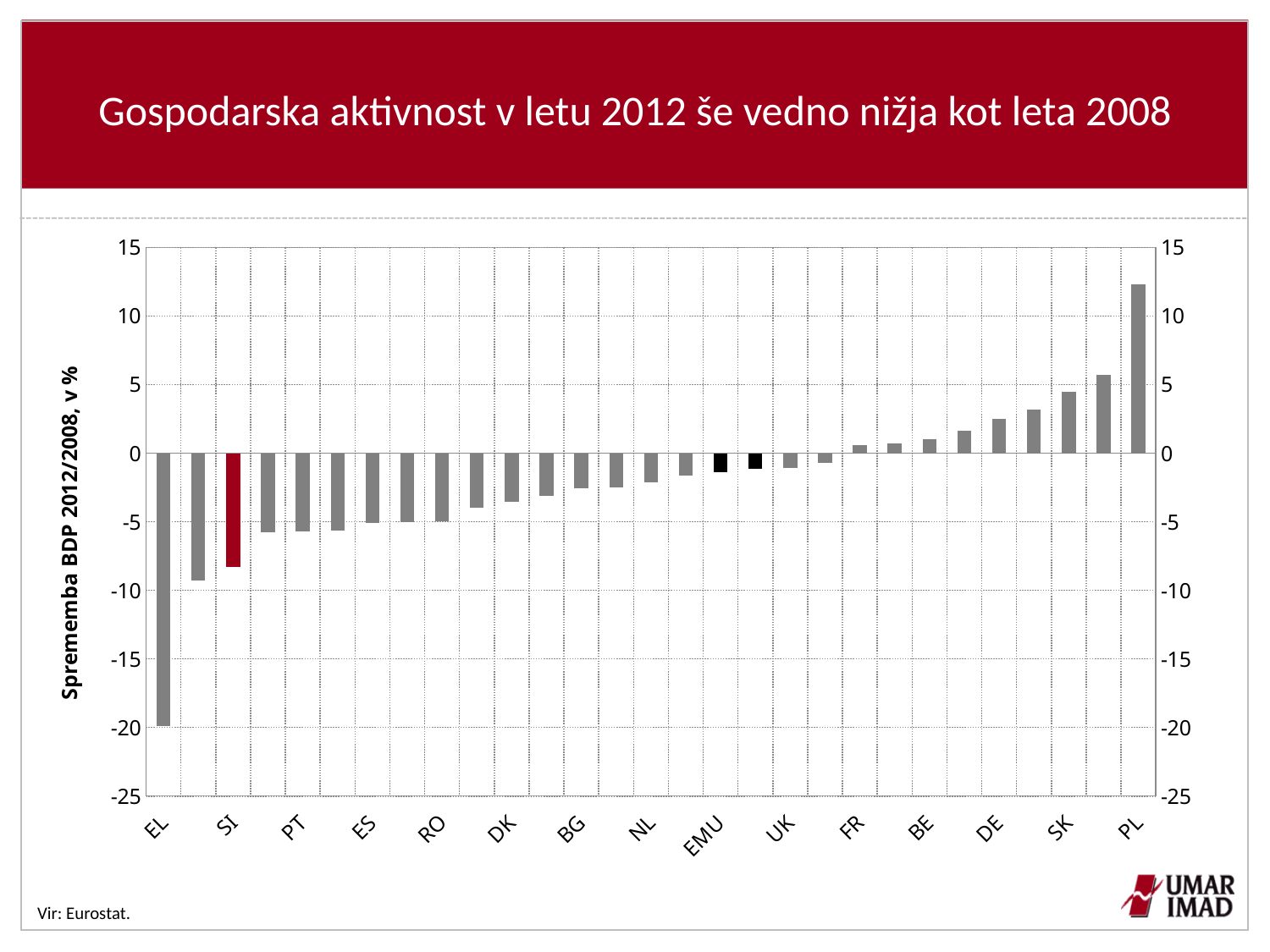
Is the value for PL greater or less than 10? greater What is the title of the vertical axis? Sprememba BDP 2012/2008, v % Is the value for DK greater or less than -5? greater Do the values generally rise or fall moving from left to right along the x axis? rise Which has the larger value, EL or SI? SI Which has the larger value, PL or SK? PL Is the value for SI greater or less than -5? less Which category has the highest value in the chart? PL What kind of chart is shown on the slide? bar chart Which category has the lowest value in the chart? EL